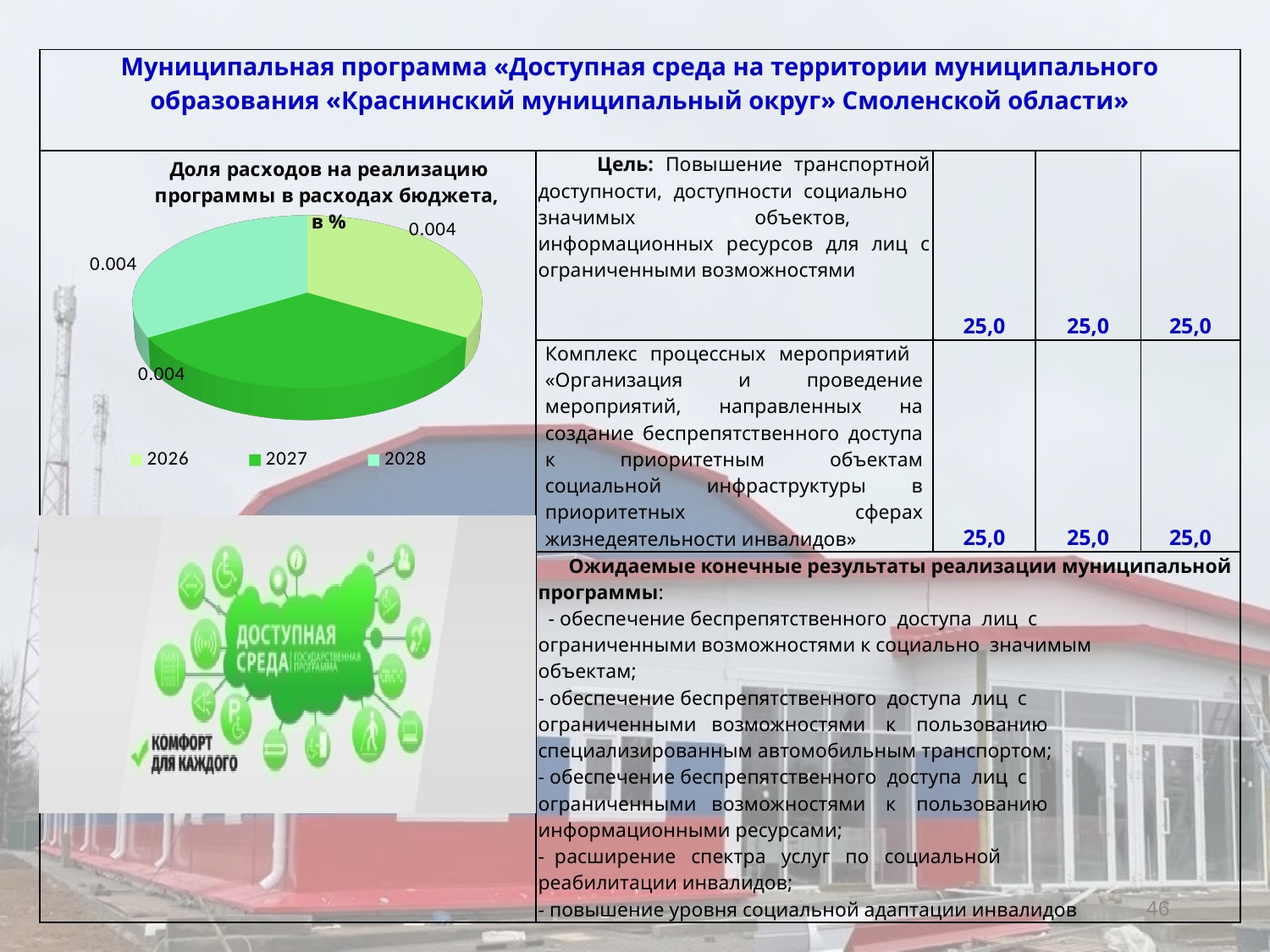
What is the title of the pie chart? Доля расходов на реализацию программы в расходах бюджета, в % What is the difference between the values for 2026 and 2027 in the pie chart? 0 Which years are listed in the legend of the pie chart? 2026, 2027, 2028 What kind of chart is shown on the slide? pie chart What is the value shown for 2028 in the pie chart? 0.004 How many slices does the pie chart have? 3 What is the value shown for 2027 in the pie chart? 0.004 What is the value shown for 2026 in the pie chart? 0.004 How many entries does the legend of the pie chart list? 3